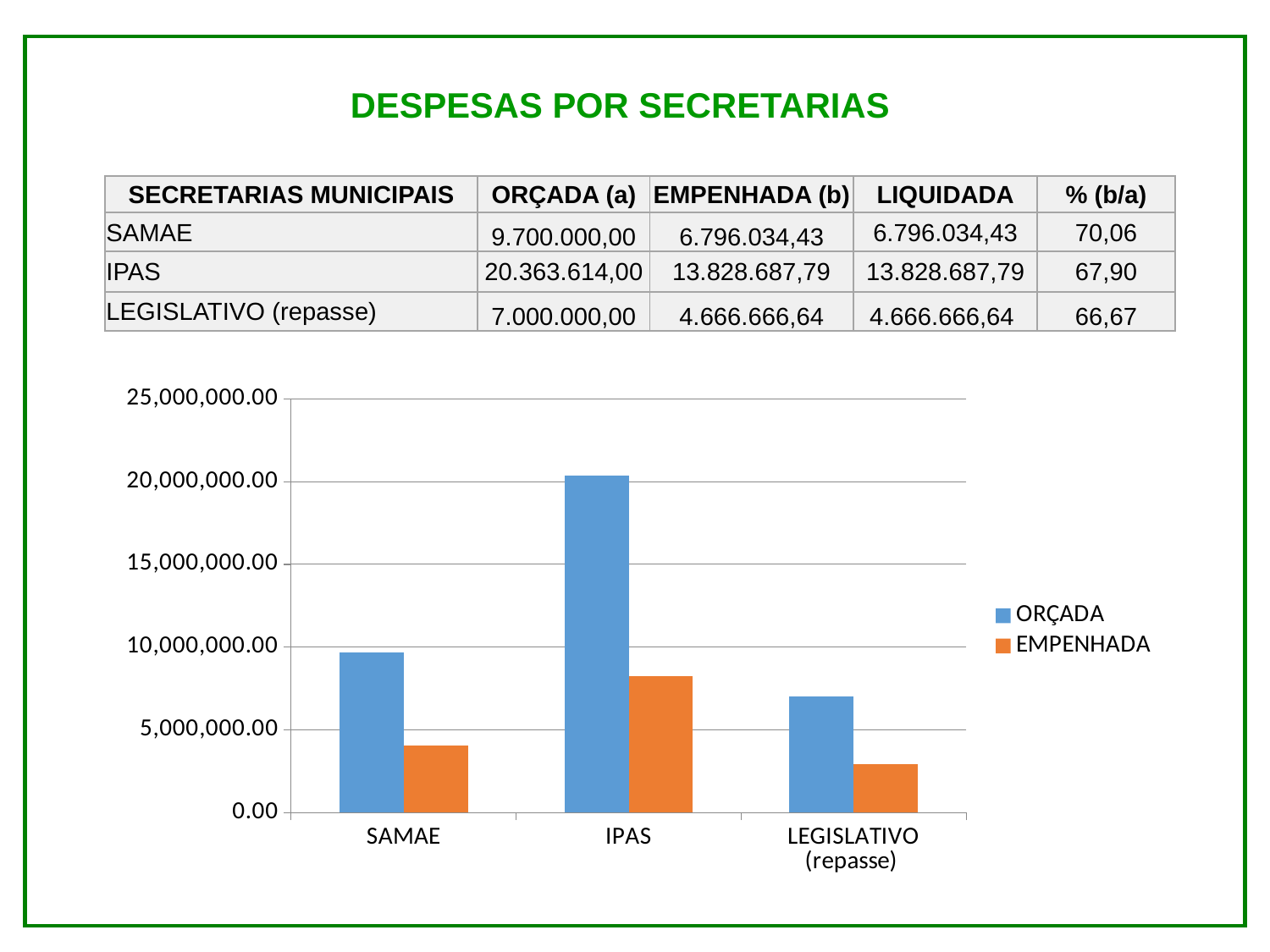
Which category has the lowest ORÇADA bar in the chart? LEGISLATIVO (repasse) Which category has the highest ORÇADA bar in the chart? IPAS Which category has the lowest EMPENHADA bar in the chart? LEGISLATIVO (repasse) Is the ORÇADA value for IPAS greater or less than 20,000,000.00? greater How many series does the chart legend list? 2 Is the ORÇADA value for SAMAE greater or less than 5,000,000.00? greater In the chart, which is larger for SAMAE: the ORÇADA bar or the EMPENHADA bar? ORÇADA How many categories are shown on the x axis of the chart? 3 What colour are the EMPENHADA bars in the chart? orange What kind of chart is shown on the slide? bar chart